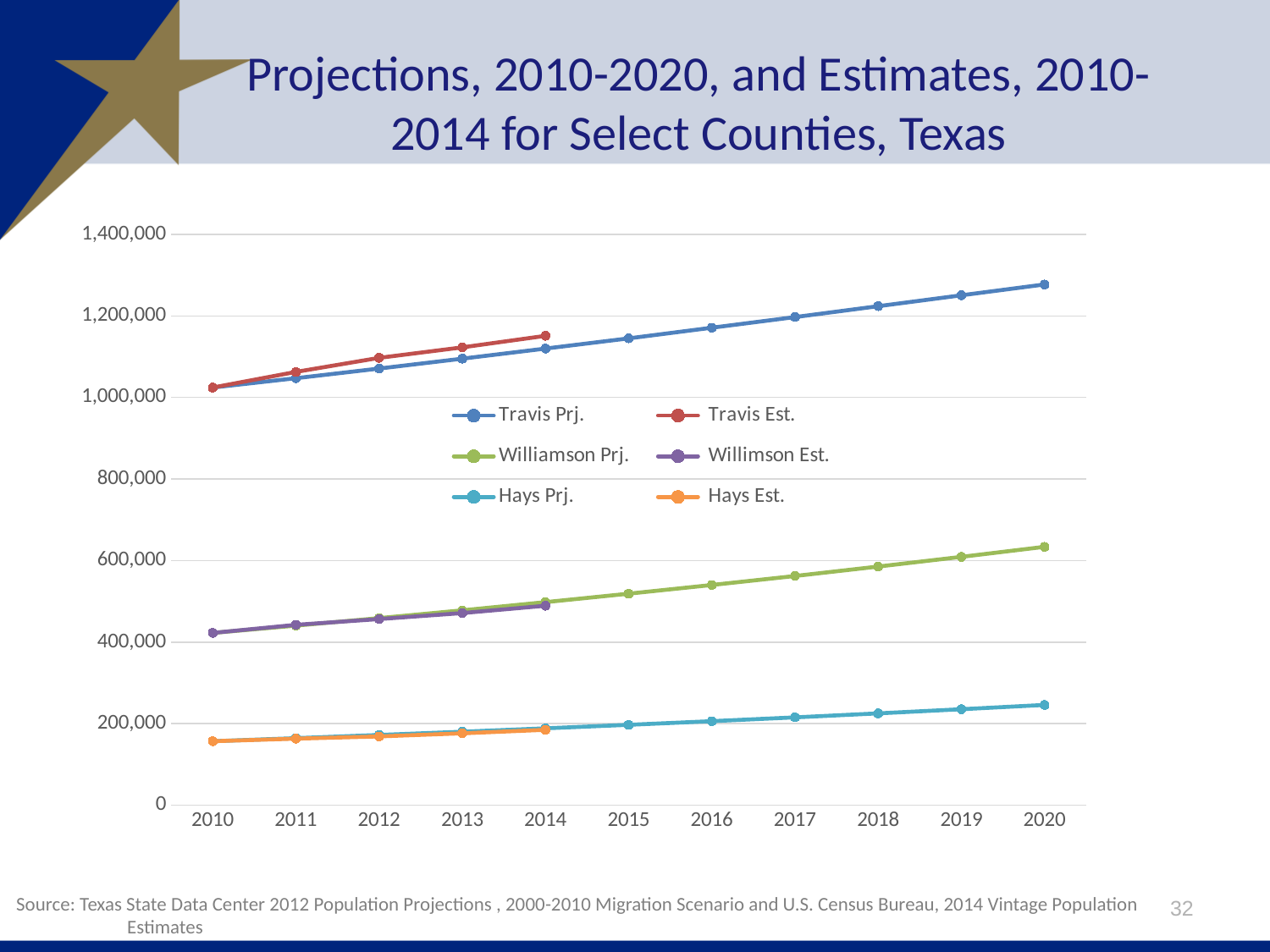
Is the value for Travis Prj. in 2020 greater or less than 1,200,000? greater Which series has the highest value in 2020? Travis Prj. Which legend entry is shown with an orange line? Hays Est. What kind of chart is shown on the slide? Line chart Does the Travis Prj. line rise or fall from 2010 to 2020? Rises Is the value for Hays Prj. in 2010 greater or less than 200,000? less How many series does the legend list? 6 Is the value for Travis Est. in 2014 greater or less than 1,200,000? less Which series has the lowest value in 2020? Hays Prj. In 2014, which is higher: Travis Est. or Travis Prj.? Travis Est. How many years are shown along the x axis? 11